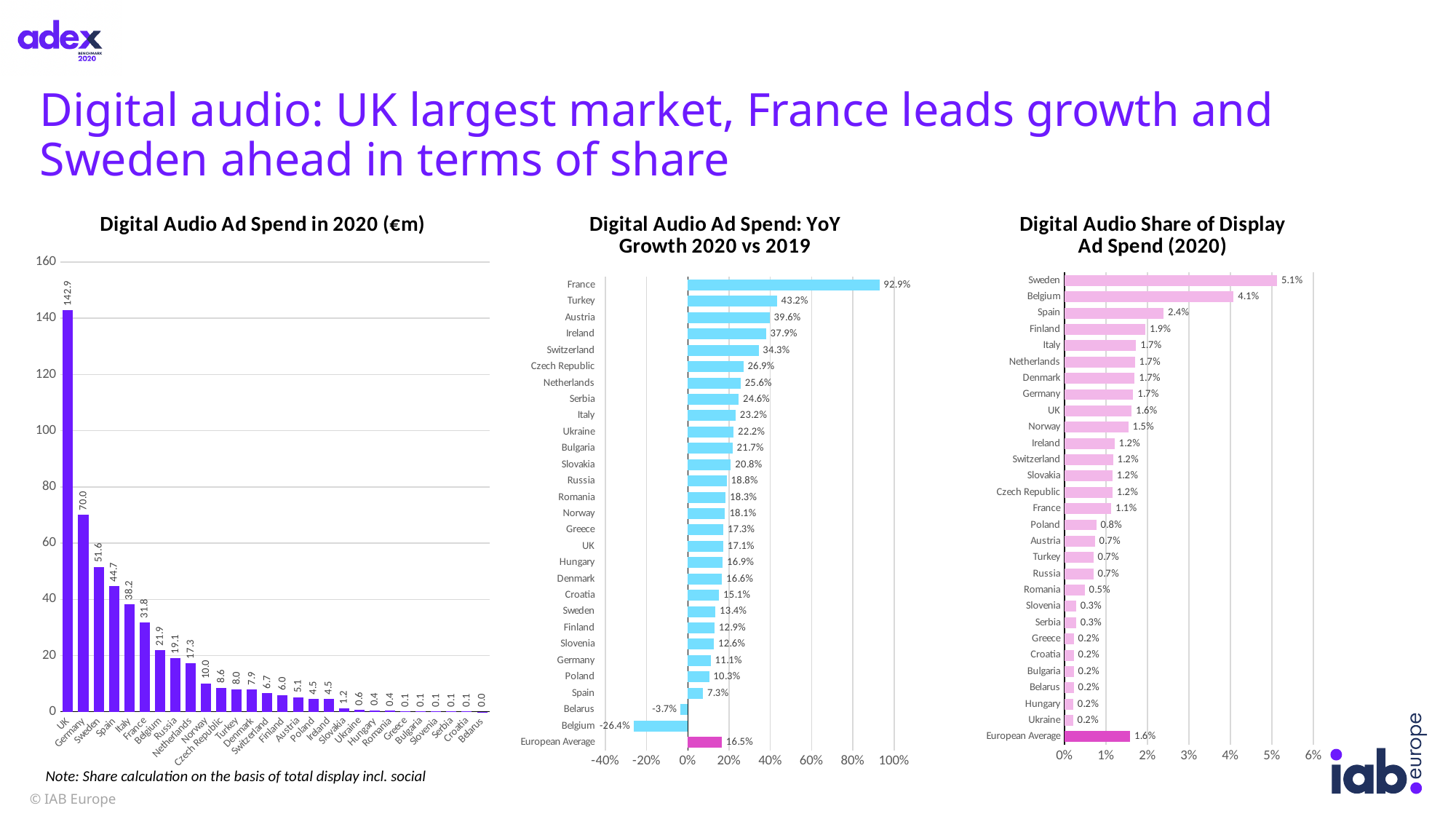
In the 'Digital Audio Share of Display Ad Spend (2020)' chart, what is the difference between the shares for Sweden and Spain? 2.7% In the 'Digital Audio Ad Spend: YoY Growth 2020 vs 2019' chart, which country has the lowest growth? Belgium In the 'Digital Audio Ad Spend in 2020 (€m)' chart, what is the difference between the values for Sweden and Spain? 6.9 In the 'Digital Audio Ad Spend: YoY Growth 2020 vs 2019' chart, what is the European Average value? 16.5% In the 'Digital Audio Ad Spend: YoY Growth 2020 vs 2019' chart, what is the growth value for Turkey? 43.2% In the 'Digital Audio Ad Spend: YoY Growth 2020 vs 2019' chart, which has the larger growth, Austria or Ireland? Austria In the 'Digital Audio Share of Display Ad Spend (2020)' chart, which country has the highest share? Sweden In the 'Digital Audio Ad Spend in 2020 (€m)' chart, what kind of chart is shown? Bar chart How many charts are shown on the slide? 3 In the 'Digital Audio Ad Spend in 2020 (€m)' chart, what is the value for Germany? 70.0 In the 'Digital Audio Share of Display Ad Spend (2020)' chart, what is the share for Belgium? 4.1% In the 'Digital Audio Ad Spend in 2020 (€m)' chart, which country has the highest ad spend? UK